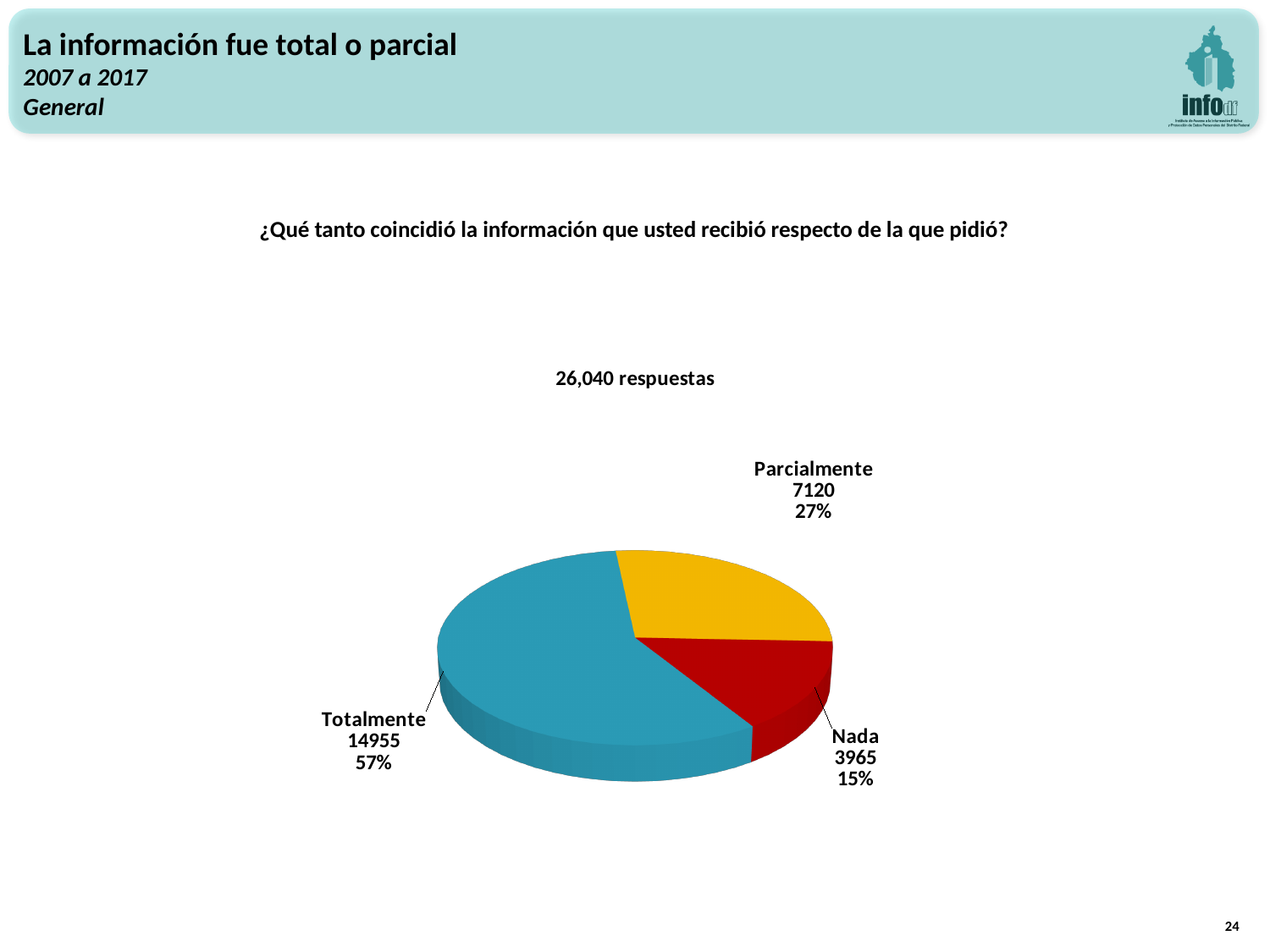
What is the number of responses for Parcialmente? 7120 What is the number of responses for Nada? 3965 What is the difference in responses between Totalmente and Parcialmente? 7835 What kind of chart is shown on the slide? pie chart Which has more responses, Parcialmente or Nada? Parcialmente What share of the pie does Totalmente represent? 57% What total number of responses is stated above the chart? 26,040 respuestas What share of the pie does Nada represent? 15% How many slices does the pie chart have? 3 Which category has the smallest slice? Nada Which category has the largest slice? Totalmente What is the number of responses for Totalmente? 14955